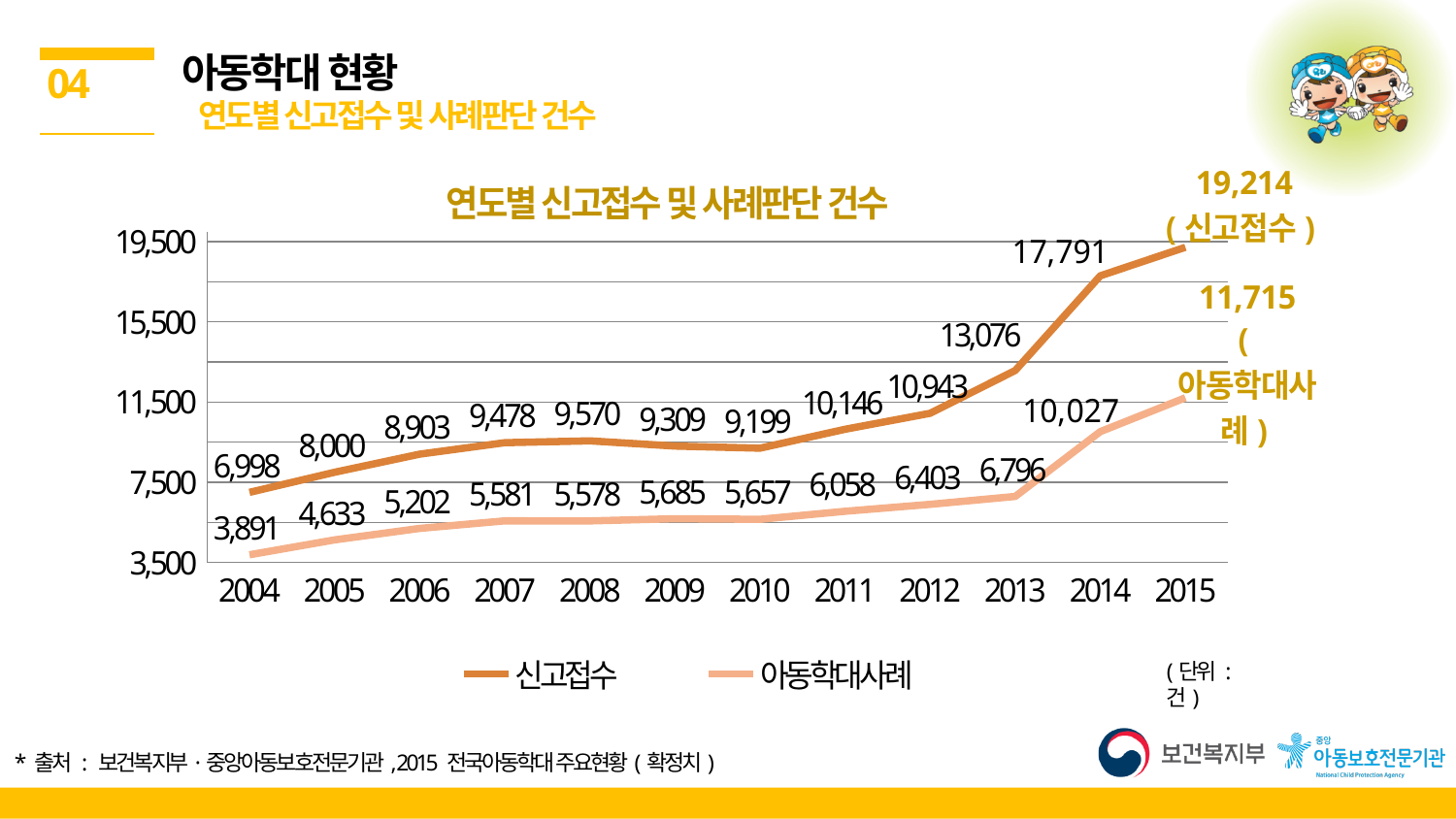
What is the value of 신고접수 in 2013? 13,076 What type of chart is shown on the slide? Line chart What is the overall trend of 아동학대사례 from 2004 to 2015? Rising How many years are shown on the x axis? 12 What is the value of 신고접수 in 2015? 19,214 What is the difference between 신고접수 and 아동학대사례 in 2015? 7,499 What is the value of 아동학대사례 in 2004? 3,891 What is the value of 아동학대사례 in 2014? 10,027 In which year is 신고접수 the highest? 2015 How many series does the legend list? 2 Which is larger, 신고접수 in 2008 or 신고접수 in 2009? 2008 In which year is 아동학대사례 the lowest? 2004